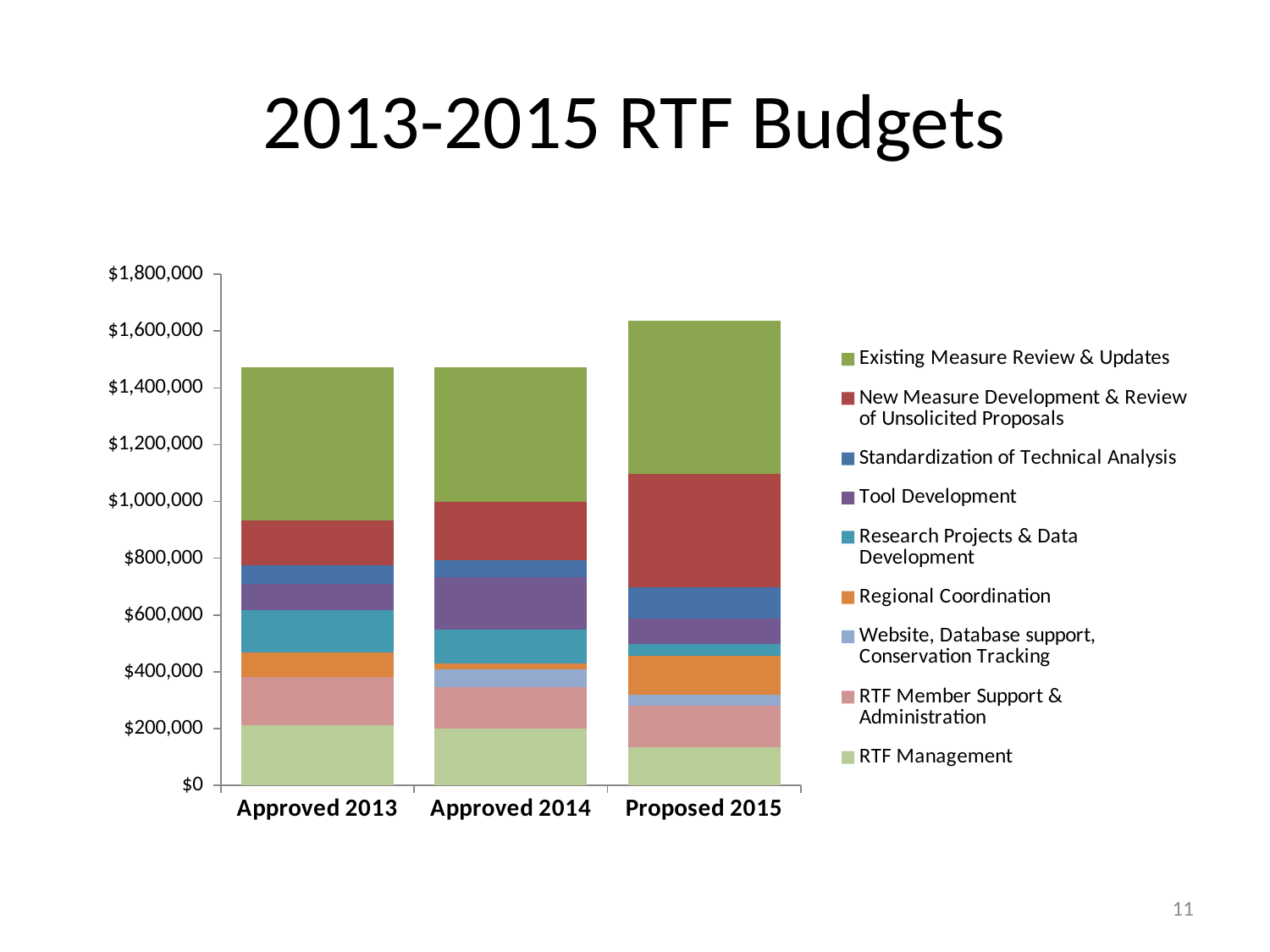
Which is larger, the Regional Coordination segment in Proposed 2015 or in Approved 2014? Proposed 2015 Which is larger, the total for Proposed 2015 or the total for Approved 2014? Proposed 2015 Is the total for Approved 2013 greater or less than $1,600,000? less Is the total for Proposed 2015 greater or less than $1,400,000? greater What kind of chart is shown on the slide? Stacked bar chart How many series does the legend list? 9 How many budget years (bars) are shown on the x axis? 3 Is the total for Approved 2014 greater or less than $1,200,000? greater Which series is shown at the bottom of each stacked bar? RTF Management Which is larger, the Tool Development segment in Approved 2014 or in Proposed 2015? Approved 2014 Which bar has the highest total budget? Proposed 2015 What is the title of the chart? 2013-2015 RTF Budgets